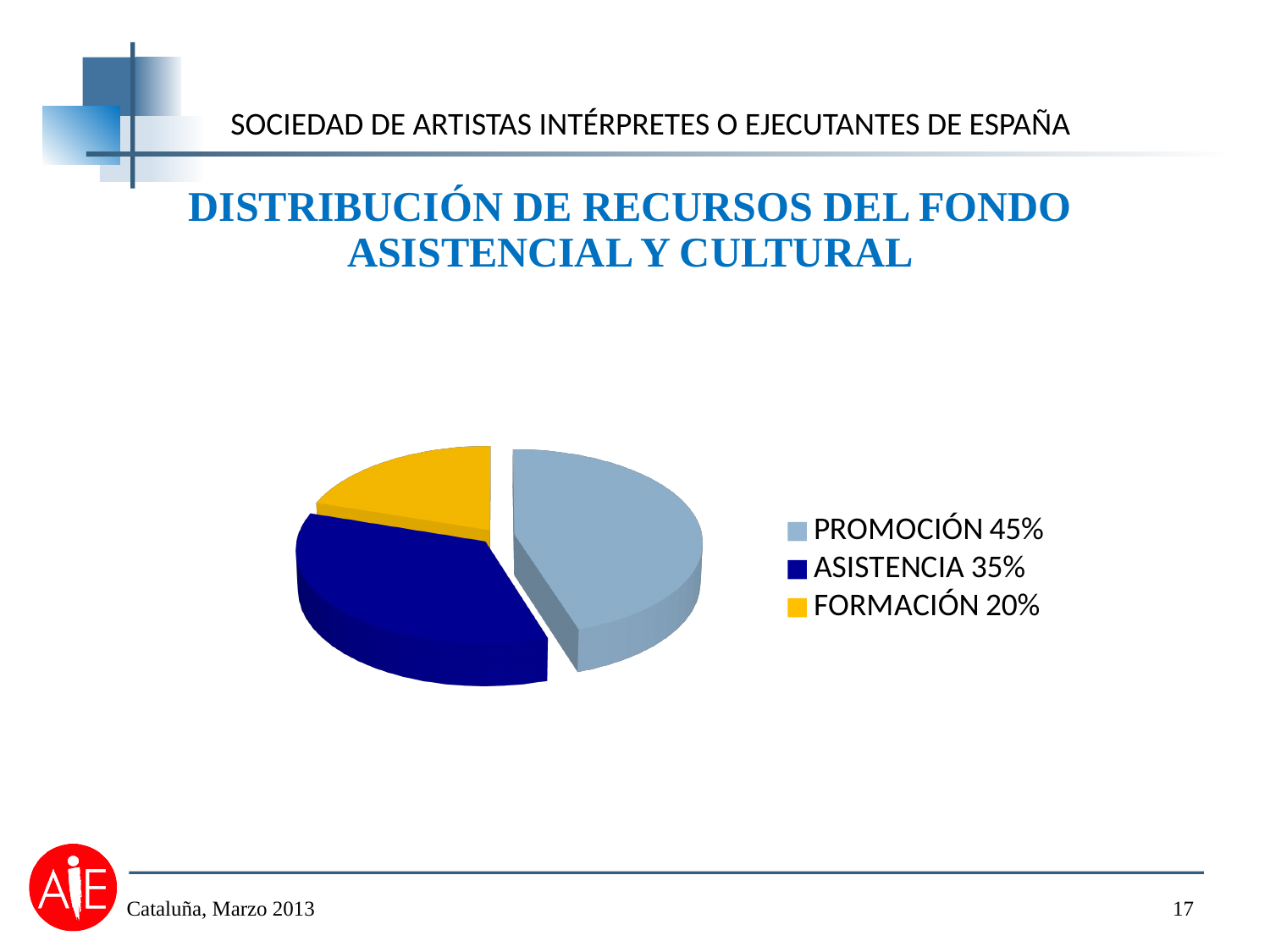
What is the difference in percentage points between ASISTENCIA and FORMACIÓN? 15% What share of the fund goes to FORMACIÓN? 20% Which category has the largest share of the pie? PROMOCIÓN What is the difference in percentage points between PROMOCIÓN and ASISTENCIA? 10% What share of the fund goes to ASISTENCIA? 35% Which is larger, the share for ASISTENCIA or the share for FORMACIÓN? ASISTENCIA What share of the fund goes to PROMOCIÓN? 45% Which category has the smallest share of the pie? FORMACIÓN What is the title of the chart? DISTRIBUCIÓN DE RECURSOS DEL FONDO ASISTENCIAL Y CULTURAL What colour is the FORMACIÓN slice? Yellow What kind of chart is shown on the slide? Pie chart How many slices does the pie chart have? 3